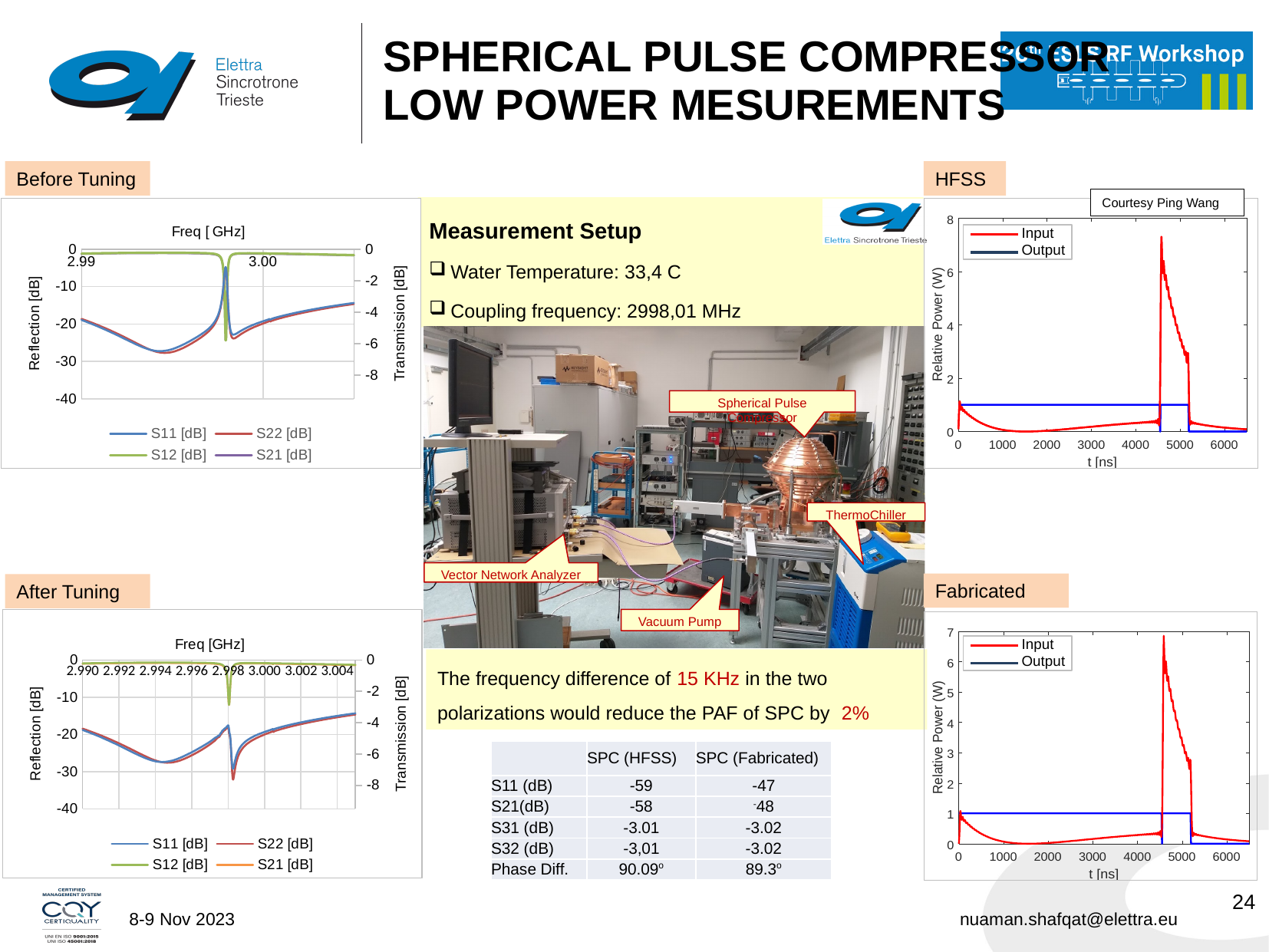
How many tick labels are shown on the horizontal axis of the After Tuning chart? 8 In the Fabricated chart, is the peak value of the Input series greater or less than 6? greater What is the label of the right vertical axis of the After Tuning chart? Transmission [dB] In the Before Tuning chart, is the lowest value of S11 [dB] greater or less than -20? less In the HFSS chart, is the peak value of the Input series greater or less than 6? greater How many series does the legend of the HFSS chart list? 2 What kind of chart is the Before Tuning chart? line chart How many series does the legend of the After Tuning chart list? 4 What is the label of the horizontal axis of the Fabricated chart? t [ns] How many series does the legend of the Before Tuning chart list? 4 In the HFSS chart, which series reaches the higher peak, Input or Output? Input What is the label of the left vertical axis of the Before Tuning chart? Reflection [dB]